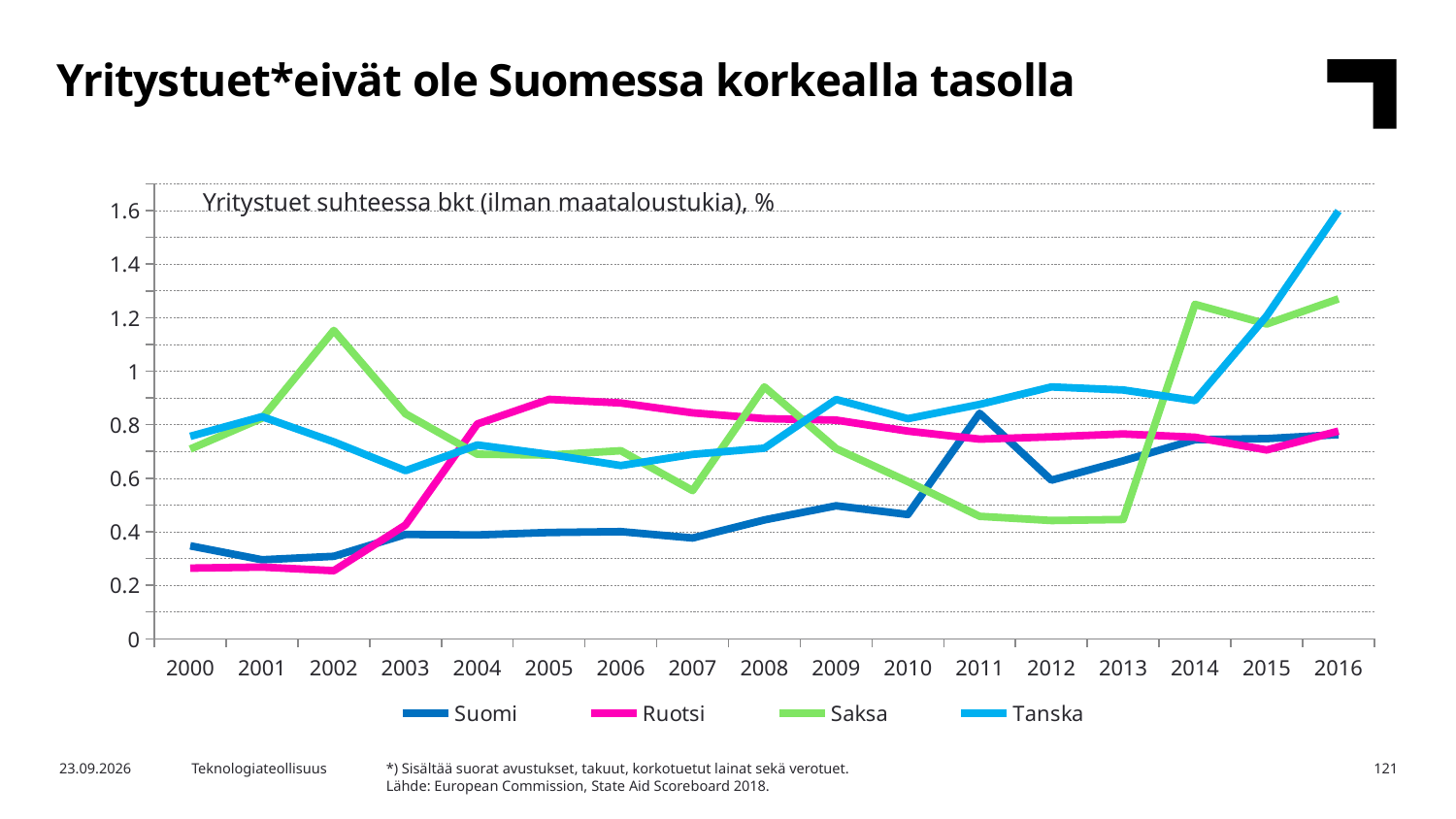
Which country has the lowest value in 2000? Ruotsi How many series does the legend list? 4 What kind of chart is shown on the slide? line chart Does the value for Ruotsi rise or fall overall from 2000 to 2016? rise Which country has the highest value in 2016? Tanska What is the title of the chart? Yritystuet suhteessa bkt (ilman maataloustukia), % How many years are shown on the x axis? 17 Is the value for Ruotsi in 2000 greater or less than 0.4? less Is the value for Tanska in 2016 greater or less than 1.4? greater Is the value for Saksa in 2013 greater or less than 0.6? less In 2002, which is larger: the value for Saksa or the value for Suomi? Saksa